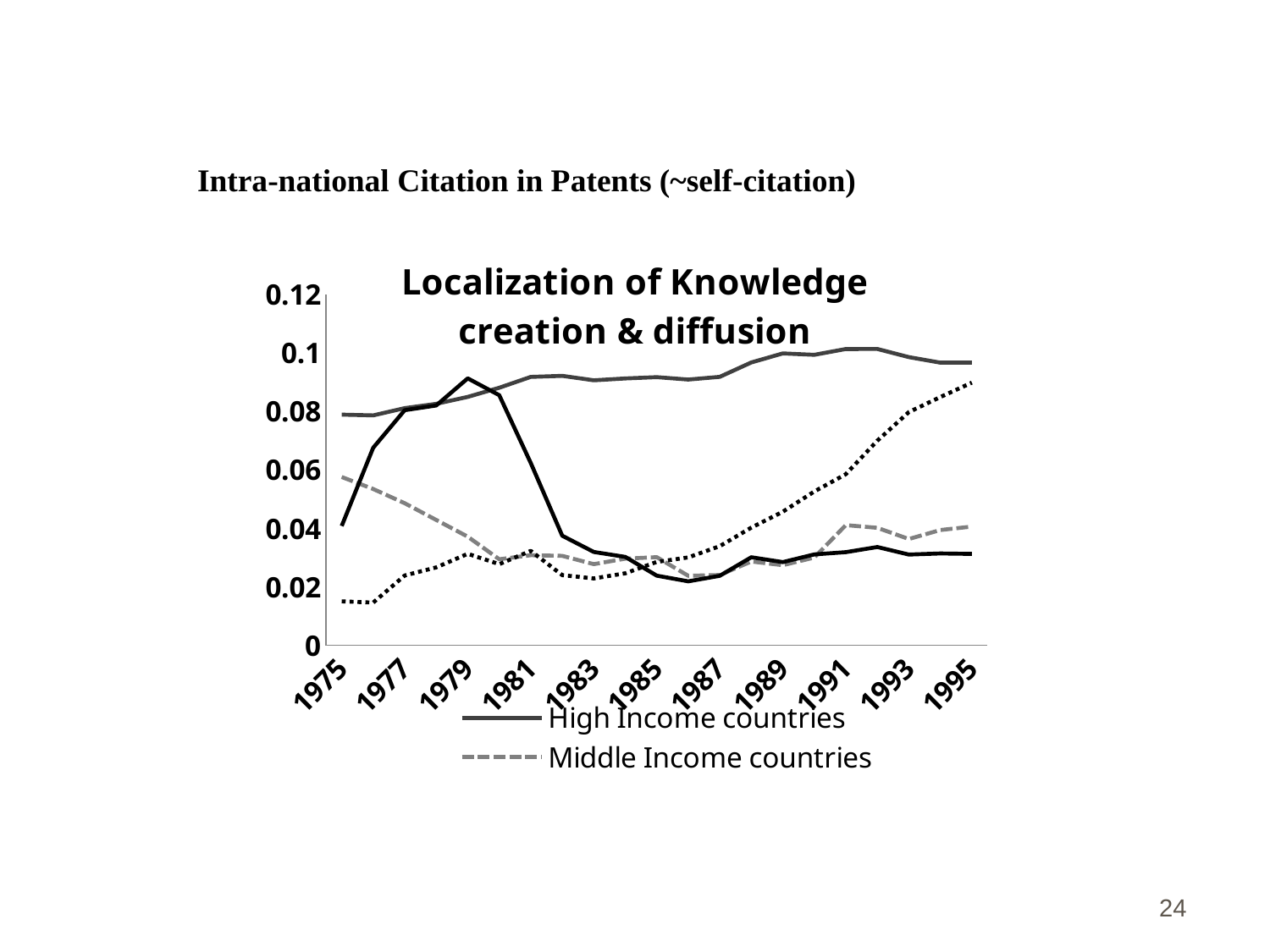
Is the value for High Income countries in 1975 greater or less than 0.06? greater Is the value for Middle Income countries in 1985 greater or less than 0.04? less Is the value for High Income countries in 1975 greater or less than 0.1? less What kind of chart is shown on the slide? line chart What is the title of the chart? Localization of Knowledge creation & diffusion Which series is drawn with a dashed line according to the legend? Middle Income countries Does the value for Middle Income countries rise or fall between 1975 and 1985? fall How many year labels are shown on the x axis? 11 Which series has the higher value in 1995, High Income countries or Middle Income countries? High Income countries